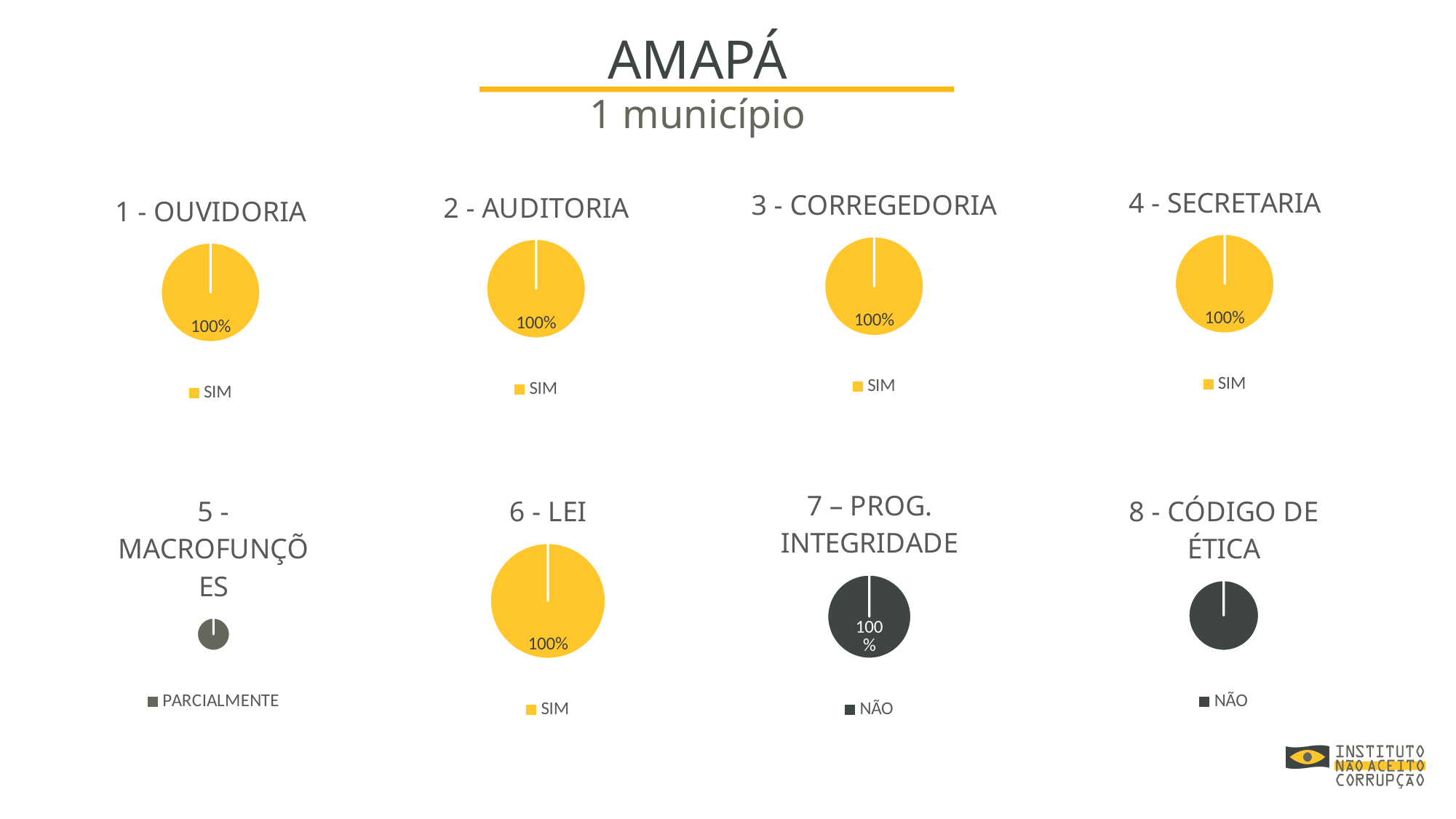
In the "7 – PROG. INTEGRIDADE" chart, what value is shown for NÃO? 100% In the "1 - OUVIDORIA" chart, what value is shown for SIM? 100% What kind of chart is the "1 - OUVIDORIA" chart? pie chart In the "2 - AUDITORIA" chart, what share of the pie does SIM take? 100% In the "3 - CORREGEDORIA" chart, what value is labelled on the SIM slice? 100% How many slices does the "4 - SECRETARIA" pie chart have? 1 How many entries does the legend of the "5 - MACROFUNÇÕES" chart list? 1 In the "6 - LEI" chart, what value is shown for SIM? 100% What is the legend entry of the "5 - MACROFUNÇÕES" chart? PARCIALMENTE What is the legend entry of the "8 - CÓDIGO DE ÉTICA" chart? NÃO How many entries does the legend of the "7 – PROG. INTEGRIDADE" chart list? 1 How many pie charts are shown on the slide? 8